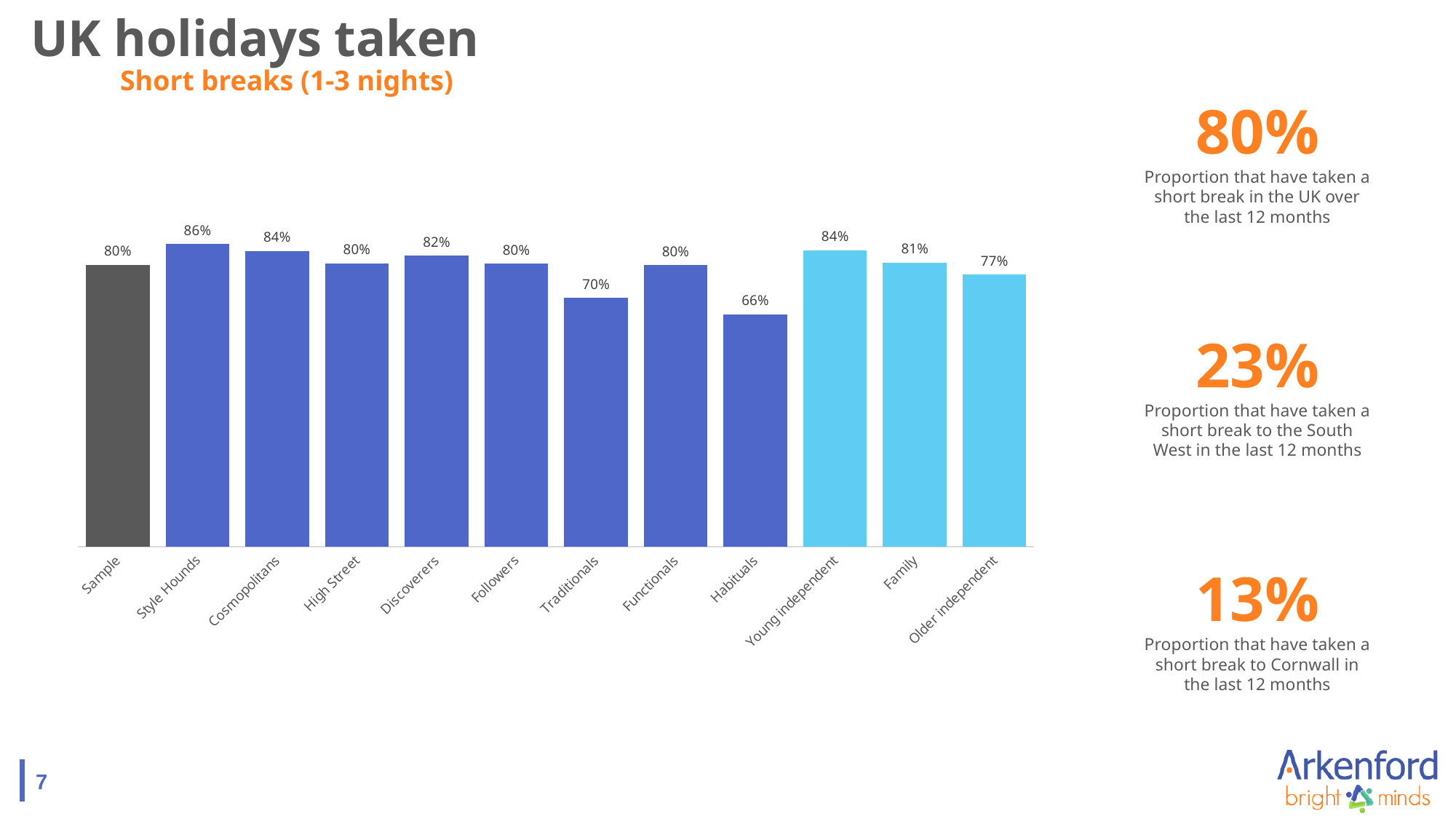
What is the value for Older independent? 77% Which is larger, the value for Cosmopolitans or the value for Family? Cosmopolitans What is the difference between the values for Discoverers and Traditionals? 12% Which category has the lowest value? Habituals How many categories are shown on the x axis? 12 What is the difference between the values for Style Hounds and Habituals? 20% What kind of chart is shown on the slide? Bar chart What is the value for Habituals? 66% What is the value for Traditionals? 70% Which category has the highest value? Style Hounds What is the subtitle shown above the chart? Short breaks (1-3 nights) What is the value for Style Hounds? 86%